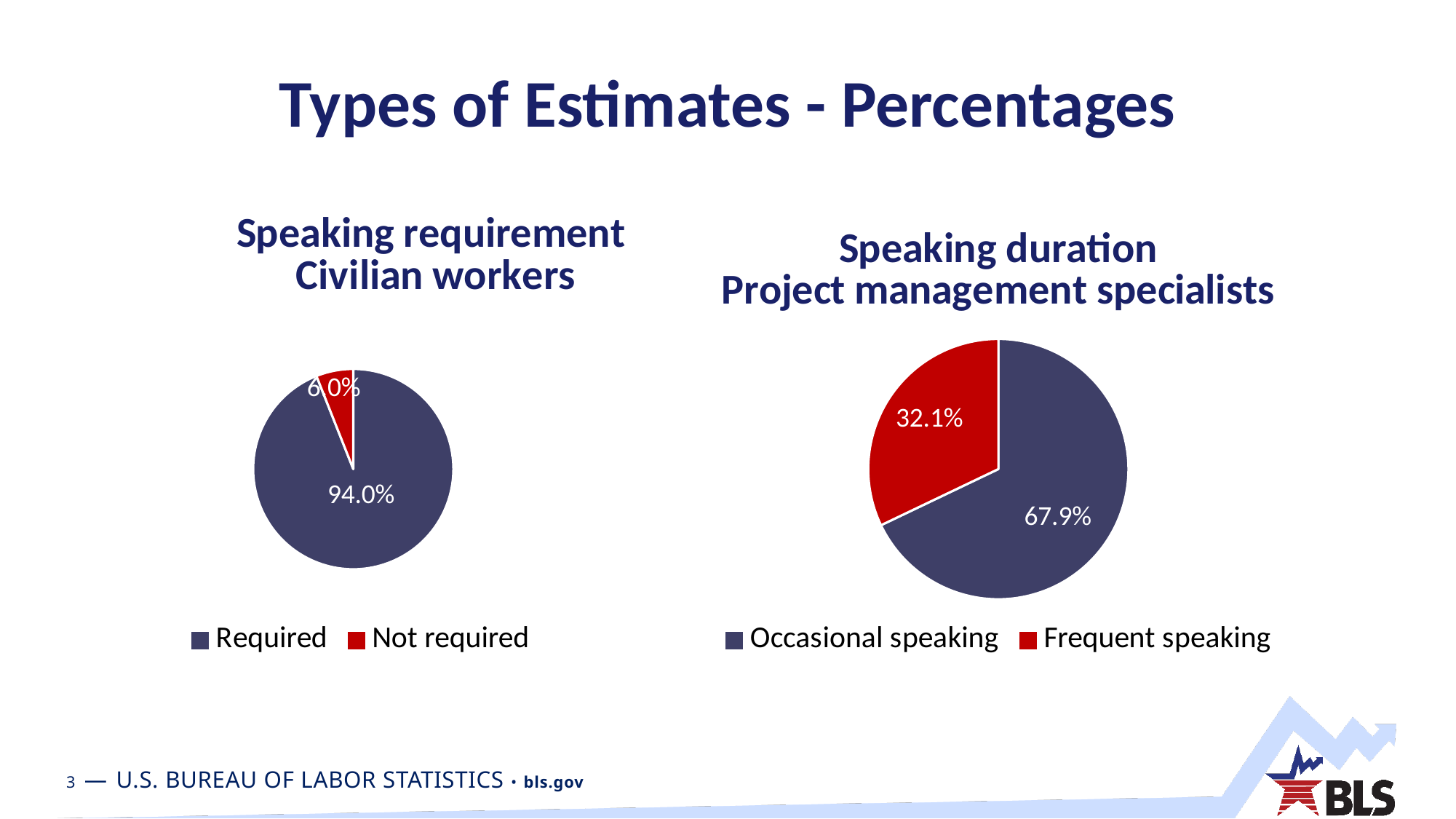
In the 'Speaking duration Project management specialists' chart, what is the difference in percentage points between Occasional speaking and Frequent speaking? 35.8 In the 'Speaking duration Project management specialists' chart, what percentage is shown for Frequent speaking? 32.1% In the 'Speaking duration Project management specialists' chart, what colour is the Frequent speaking slice? Red In the 'Speaking requirement Civilian workers' chart, what percentage is shown for Not required? 6.0% How many slices does the 'Speaking requirement Civilian workers' pie chart have? 2 In the 'Speaking duration Project management specialists' chart, which slice is the smallest? Frequent speaking What type of chart is the 'Speaking duration Project management specialists' chart? Pie chart In the 'Speaking requirement Civilian workers' chart, which slice is the largest? Required In the 'Speaking requirement Civilian workers' chart, what percentage is shown for Required? 94.0% In the 'Speaking duration Project management specialists' chart, what percentage is shown for Occasional speaking? 67.9% In the 'Speaking requirement Civilian workers' chart, which is larger: Required or Not required? Required How many entries does the legend of the 'Speaking duration Project management specialists' chart list? 2